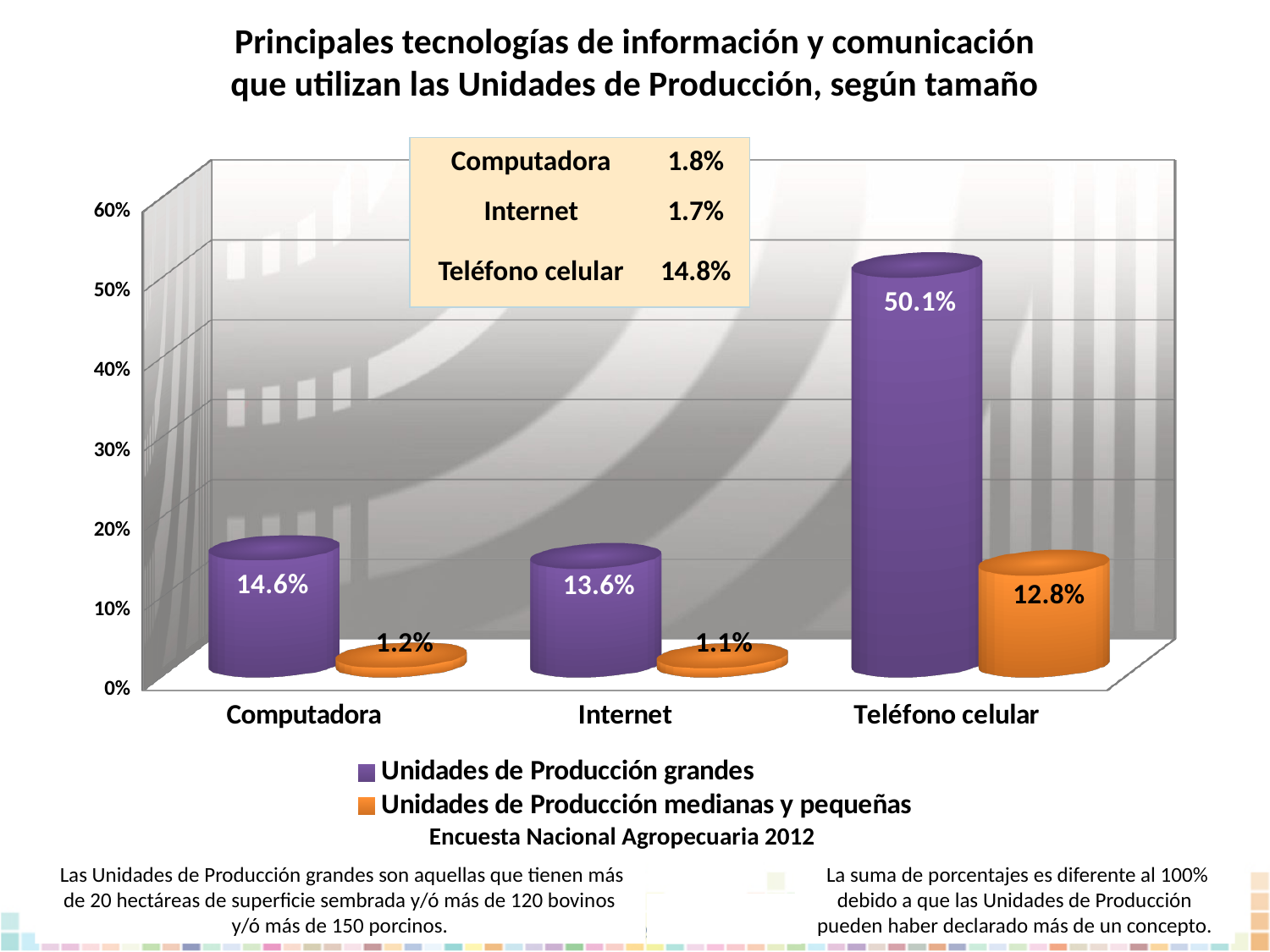
Is the value for Teléfono celular in the Unidades de Producción grandes series greater or less than 40%? greater How many categories are shown on the x axis? 3 Which category has the lowest value in the Unidades de Producción grandes series? Internet What is the value for Internet in the Unidades de Producción grandes series? 13.6% Which colour represents the Unidades de Producción medianas y pequeñas series? orange What is the value for Teléfono celular in the Unidades de Producción grandes series? 50.1% Which category has the highest value in the Unidades de Producción medianas y pequeñas series? Teléfono celular What kind of chart is shown on the slide? bar chart Which is larger: the Unidades de Producción grandes value for Computadora or for Internet? Computadora What is the difference between the Unidades de Producción grandes and the Unidades de Producción medianas y pequeñas values for Teléfono celular? 37.3% How many series does the legend list? 2 What is the value for Computadora in the Unidades de Producción medianas y pequeñas series? 1.2%